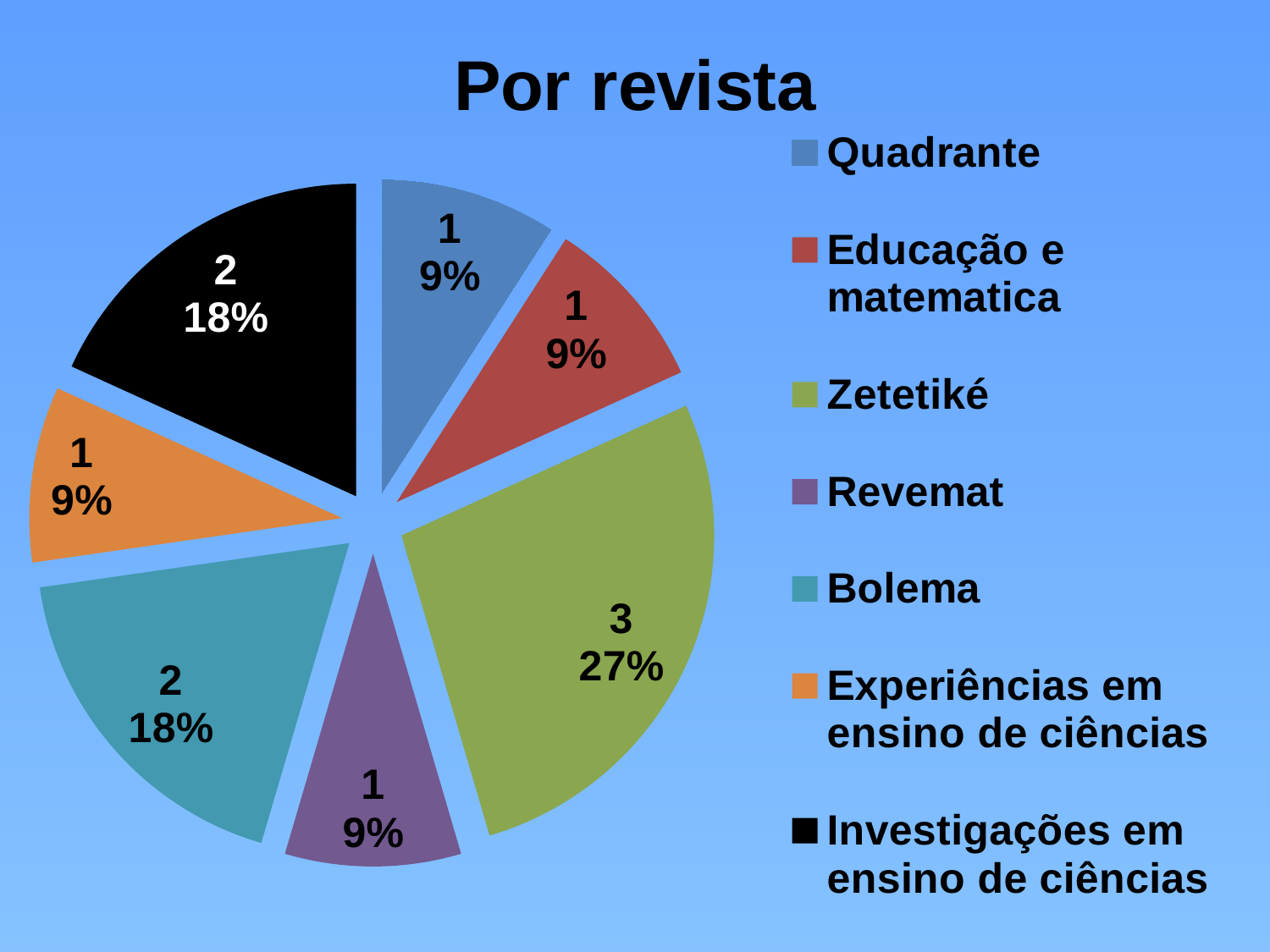
What is the difference between the value for Zetetiké and the value for Bolema? 1 What kind of chart is shown on the slide? pie chart How many slices does the pie chart have? 7 Which is larger, the value for Investigações em ensino de ciências or the value for Quadrante? Investigações em ensino de ciências What colour is the slice for Investigações em ensino de ciências? black What share of the pie does Experiências em ensino de ciências represent? 9% What share of the pie does Zetetiké represent? 27% What share of the pie does Bolema represent? 18% What is the value for Revemat? 1 What is the title of the chart? Por revista Which journal has the largest slice of the pie? Zetetiké What is the value for Zetetiké? 3